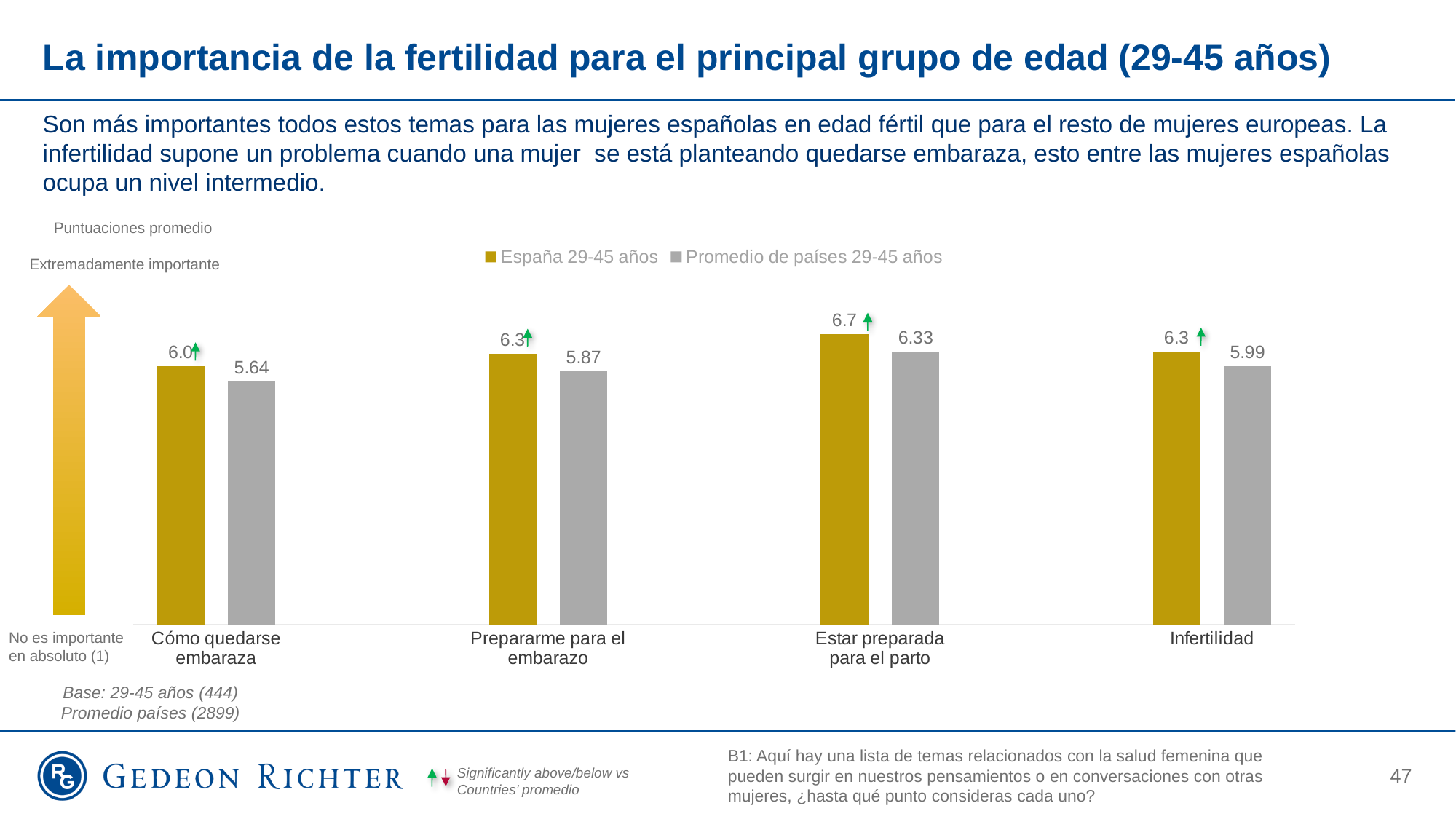
What is the value for Promedio de países 29-45 años for 'Cómo quedarse embaraza'? 5.64 How many series does the chart legend list? 2 What is the value for España 29-45 años for 'Prepararme para el embarazo'? 6.3 What is the value for Promedio de países 29-45 años for 'Infertilidad'? 5.99 Which category has the highest value for España 29-45 años? Estar preparada para el parto How many categories are shown on the x axis of the chart? 4 What kind of chart is shown on the slide? Bar chart For 'Infertilidad', which is larger: the España 29-45 años value or the Promedio de países 29-45 años value? España 29-45 años What is the difference between the España 29-45 años value and the Promedio de países 29-45 años value for 'Prepararme para el embarazo'? 0.43 What is the difference between the España 29-45 años value and the Promedio de países 29-45 años value for 'Estar preparada para el parto'? 0.37 Which category has the lowest value for Promedio de países 29-45 años? Cómo quedarse embaraza What is the value for España 29-45 años for 'Estar preparada para el parto'? 6.7